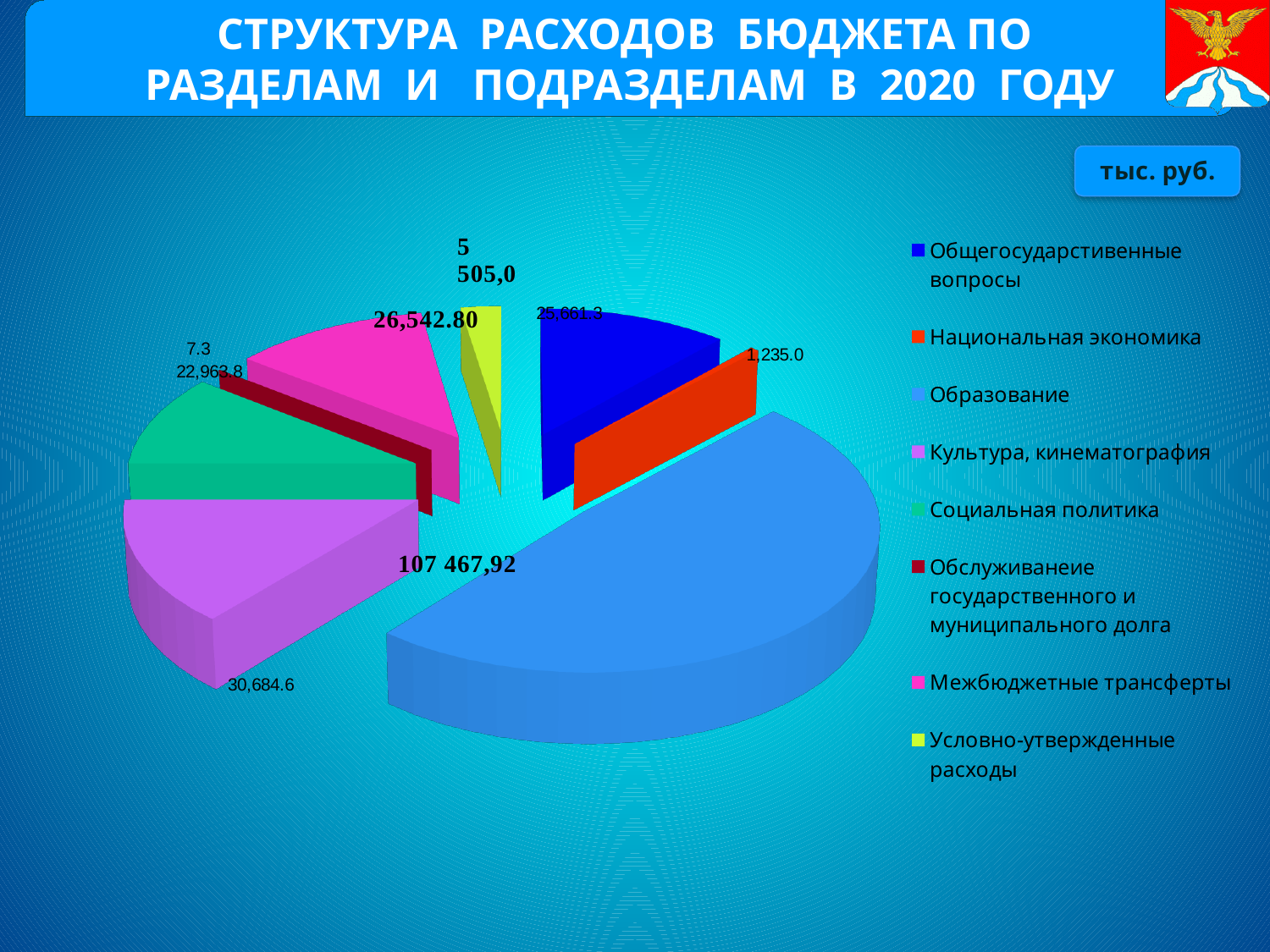
What is the value for Условно-утвержденные расходы? 5 505,0 What is the value for Межбюджетные трансферты? 26,542.80 What is the value for Национальная экономика? 1,235.0 Which category has the largest slice of the pie? Образование What is the value for Образование? 107 467,92 How many categories does the legend of the pie chart list? 8 Which category has the smallest value? Обслуживание государственного и муниципального долга What unit is indicated for the values on the slide? тыс. руб. What is the value for Культура, кинематография? 30,684.6 What is the difference between the values for Культура, кинематография and Социальная политика? 7,720.8 What kind of chart is shown on the slide? pie chart Which is larger, Культура, кинематография or Межбюджетные трансферты? Культура, кинематография